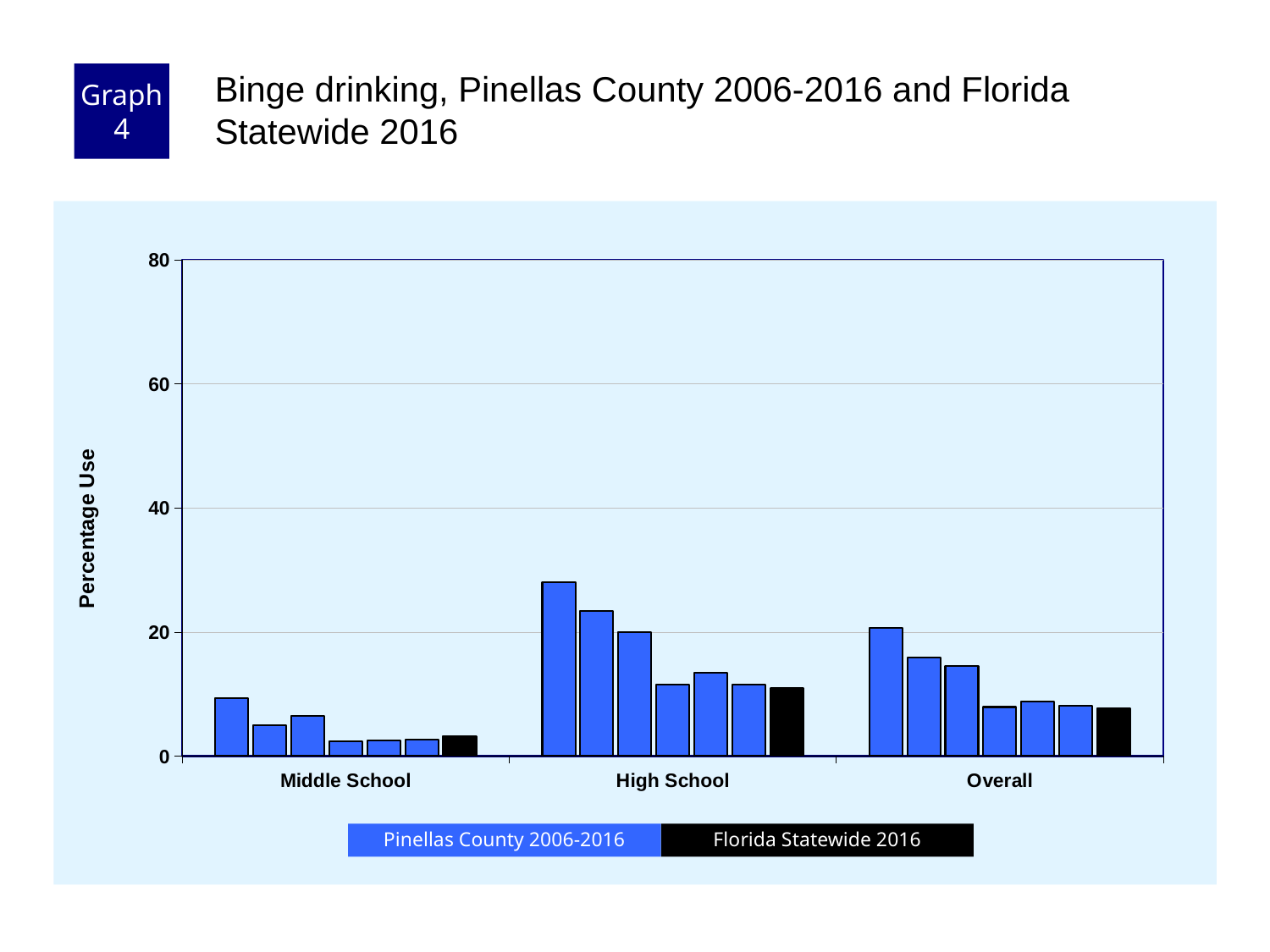
What is the label on the y axis? Percentage Use Which is larger: the Florida Statewide 2016 value for High School or for Middle School? High School Do the Pinellas County bars for High School generally rise or fall from the earliest to the latest year? fall What kind of chart is shown on the slide? bar chart Which category has the tallest bar in the chart? High School Which category has the lowest bars overall? Middle School Is the Florida Statewide 2016 value for High School greater or less than 20? less Is the tallest Pinellas County bar for Overall greater or less than 40? less Is the Florida Statewide 2016 value for Middle School greater or less than 20? less How many series does the legend list? 2 How many school-level categories are shown on the x axis? 3